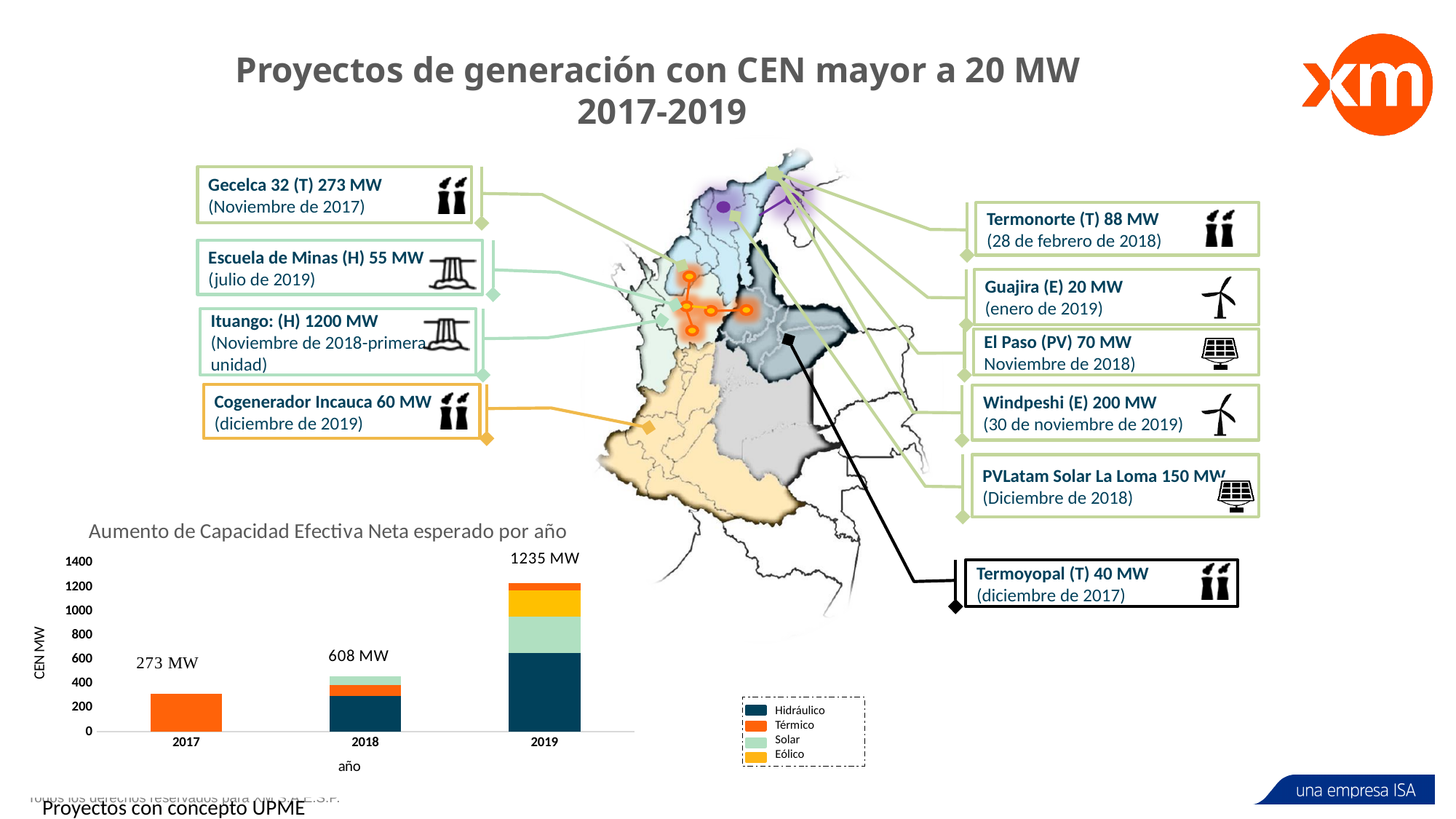
What is the total labelled on the bar for 2017? 273 MW Is the Hidráulico value for 2018 greater or less than 400? less Which year has the lowest total capacity increase? 2017 Which is larger, the total for 2018 or the total for 2017? 2018 What kind of chart is used to show the capacity increase per year? Stacked bar chart What is the difference between the 2019 total and the 2018 total? 627 MW What is the total labelled on the bar for 2019? 1235 MW How many series does the chart legend list? 4 Which year has the highest total capacity increase? 2019 What is the difference between the 2018 total and the 2017 total? 335 MW What is the total labelled on the bar for 2018? 608 MW How many years are shown on the x axis of the chart? 3